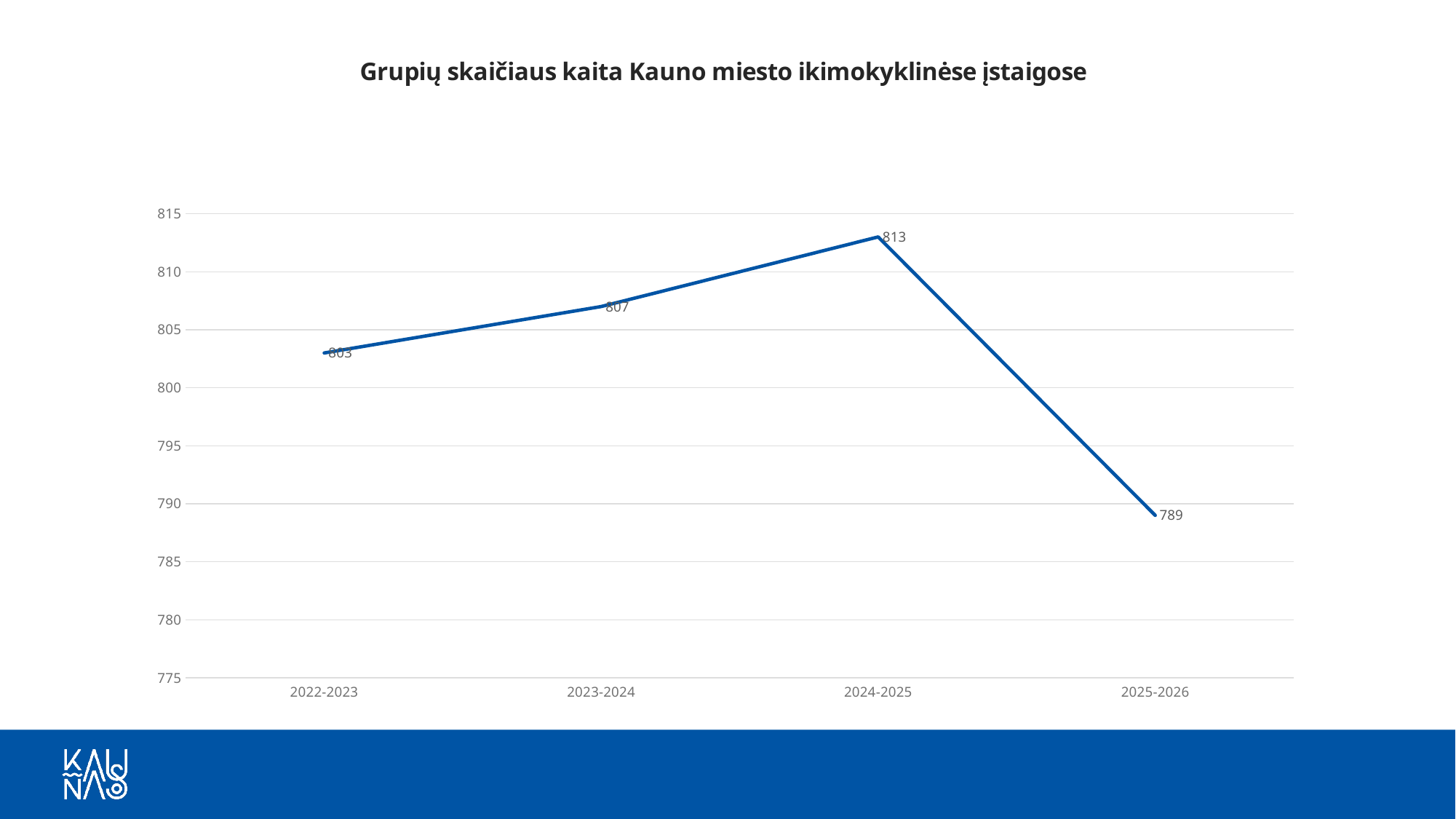
What is the title of the chart? Grupių skaičiaus kaita Kauno miesto ikimokyklinėse įstaigose Is the value for 2025-2026 greater or less than 800? less Which period has the highest value? 2024-2025 What is the value for 2023-2024? 807 What is the value for 2025-2026? 789 What is the value for 2024-2025? 813 How many periods are plotted on the x axis? 4 What kind of chart is shown? line chart Which is larger, the value for 2022-2023 or the value for 2023-2024? 2023-2024 Which period has the lowest value? 2025-2026 What is the value for 2022-2023? 803 What is the difference between the values for 2024-2025 and 2025-2026? 24